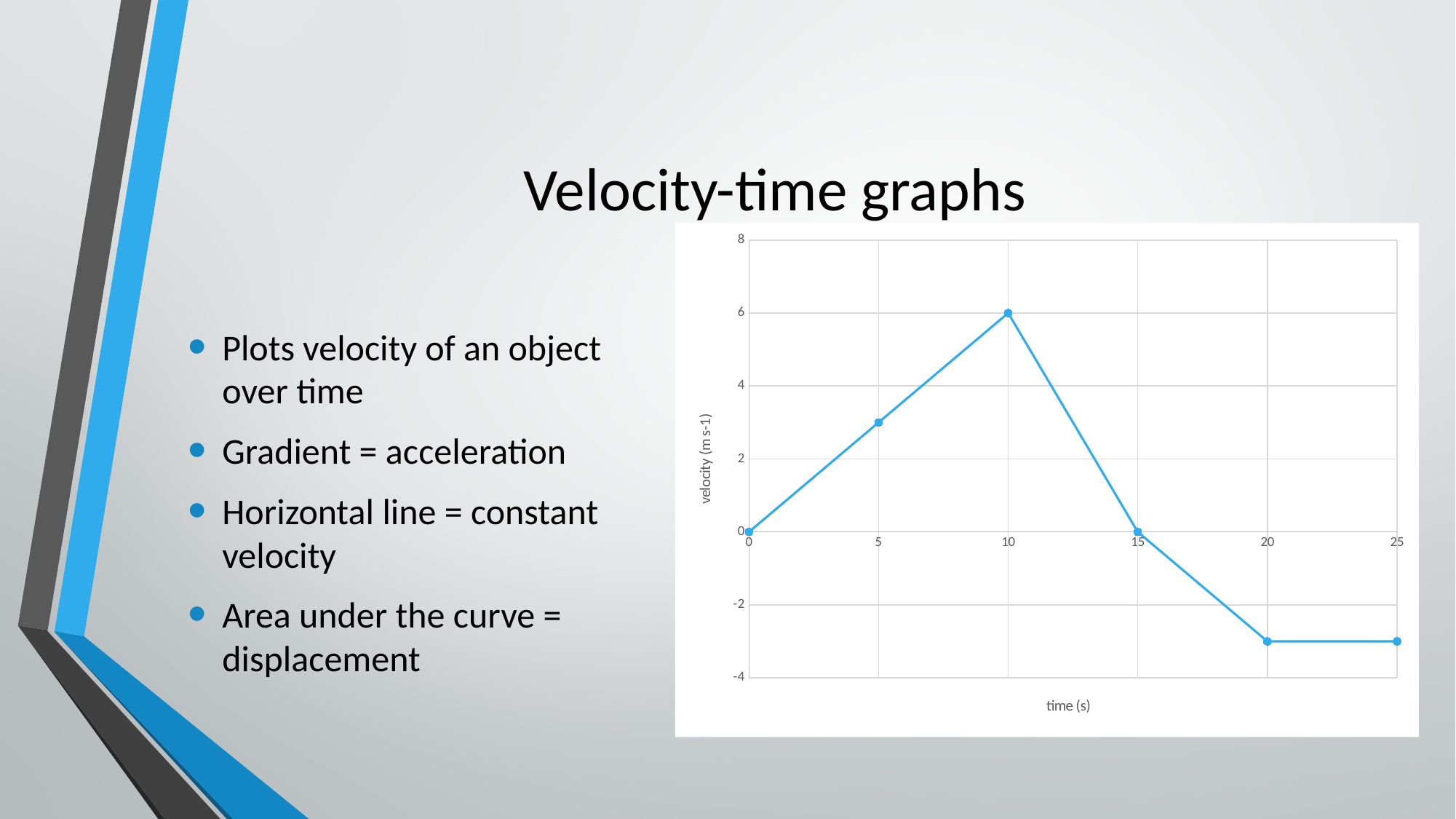
Is the velocity at time 5 s greater or less than 4? less What type of chart is shown on the slide? line chart Which is larger, the velocity at 5 s or the velocity at 10 s? 10 s Is the velocity at time 20 s greater or less than -2? less Does the velocity rise or fall between time 10 s and time 20 s? fall What is the velocity at time 10 s? 6 What is the velocity at time 15 s? 0 At which time is the velocity highest? 10 What is the velocity at time 0 s? 0 What is the difference between the velocity at 10 s and the velocity at 15 s? 6 How many data points are plotted on the chart? 6 Is the velocity at time 5 s greater or less than 2? greater